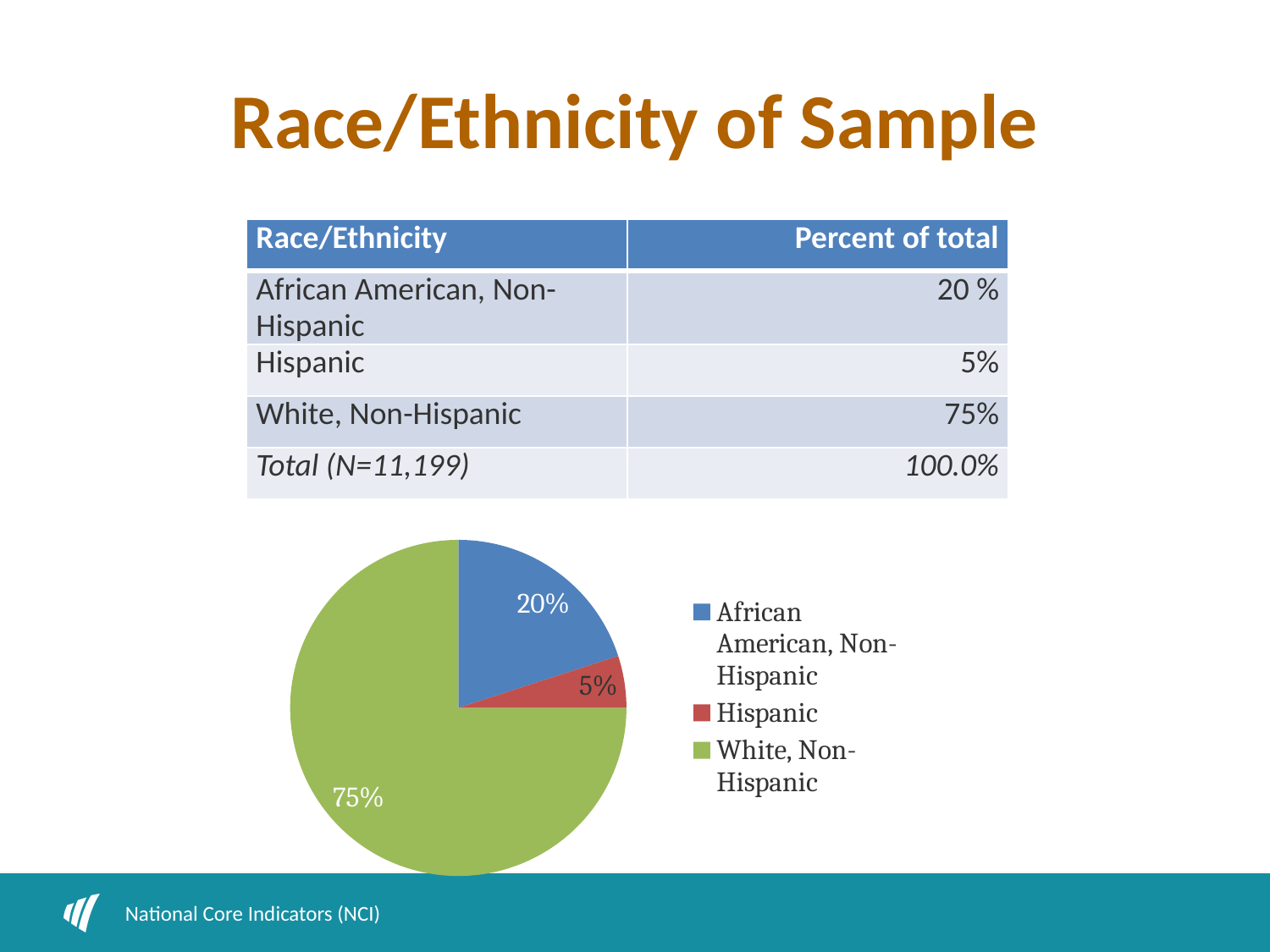
How many entries does the legend list? 3 What kind of chart is shown on the slide? Pie chart Which category has the largest slice of the pie? White, Non-Hispanic What share of the pie does the White, Non-Hispanic slice represent? 75% What colour is the White, Non-Hispanic slice in the pie chart? Green What share of the pie does the Hispanic slice represent? 5% What share of the pie does the African American, Non-Hispanic slice represent? 20% How many slices does the pie chart have? 3 What colour is the Hispanic slice in the pie chart? Red What is the difference in percentage points between the White, Non-Hispanic slice and the African American, Non-Hispanic slice? 55% Which slice is larger: African American, Non-Hispanic or Hispanic? African American, Non-Hispanic Which category has the smallest slice of the pie? Hispanic